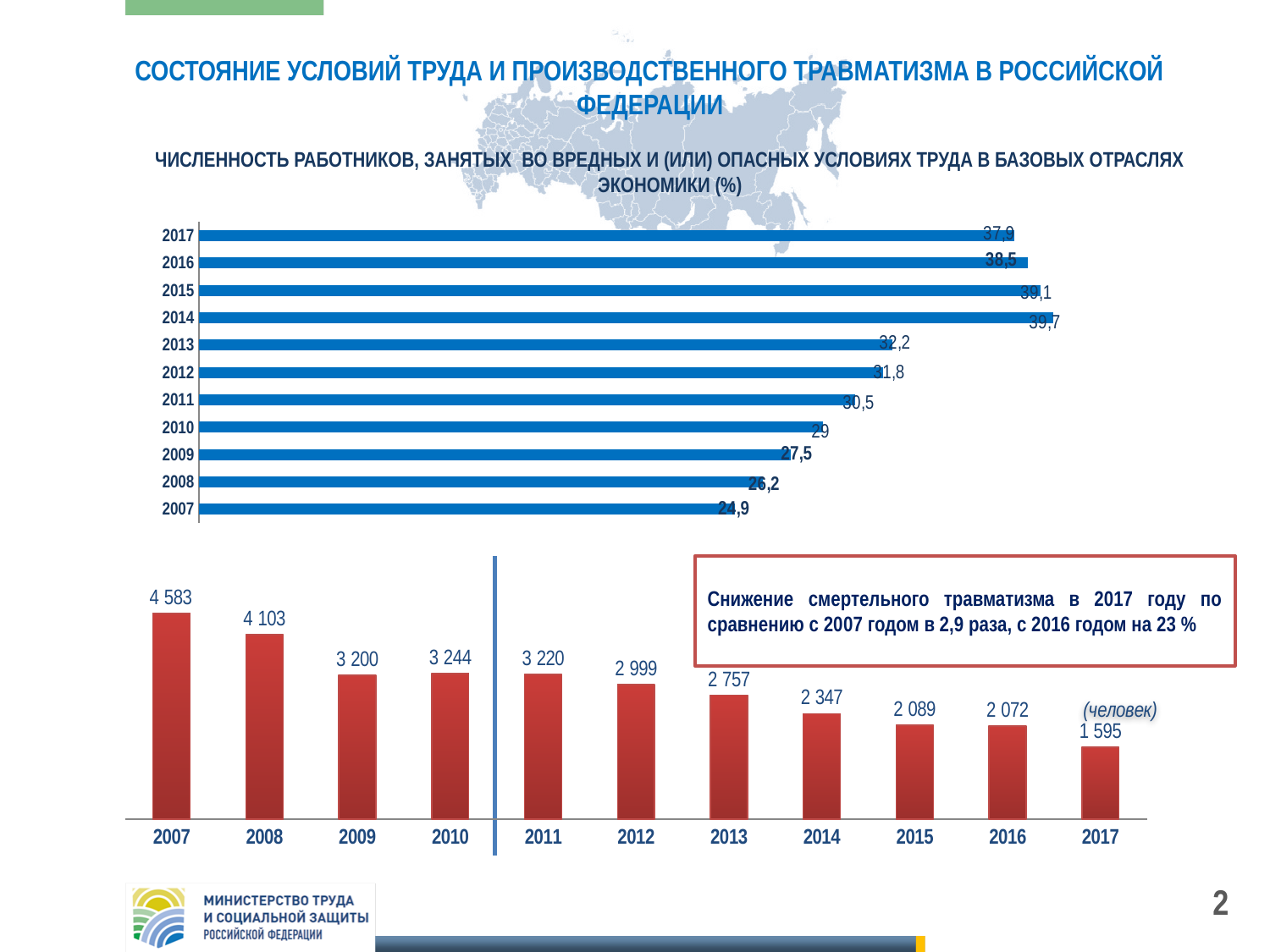
In the bottom chart (fatal injuries, persons), what is the value for 2007? 4 583 In the top chart (share of workers in harmful and/or dangerous working conditions), which year has the lowest value? 2007 In the top chart (share of workers in harmful and/or dangerous working conditions), what is the difference between the values for 2016 and 2009? 11 In the top chart (share of workers in harmful and/or dangerous working conditions), which year has the highest value? 2014 In the bottom chart (fatal injuries, persons), what is the difference between the values for 2007 and 2008? 480 In the bottom chart (fatal injuries, persons), what is the value for 2017? 1 595 In the bottom chart (fatal injuries, persons), which is larger: the value for 2010 or the value for 2009? 2010 In the bottom chart (fatal injuries, persons), which year has the lowest value? 2017 In the top chart (share of workers in harmful and/or dangerous working conditions), what is the value for 2014? 39,7 What type of chart is the bottom chart (fatal injuries, persons)? Bar chart In the top chart (share of workers in harmful and/or dangerous working conditions), how many years are shown? 11 In the top chart (share of workers in harmful and/or dangerous working conditions), what is the value for 2007? 24,9